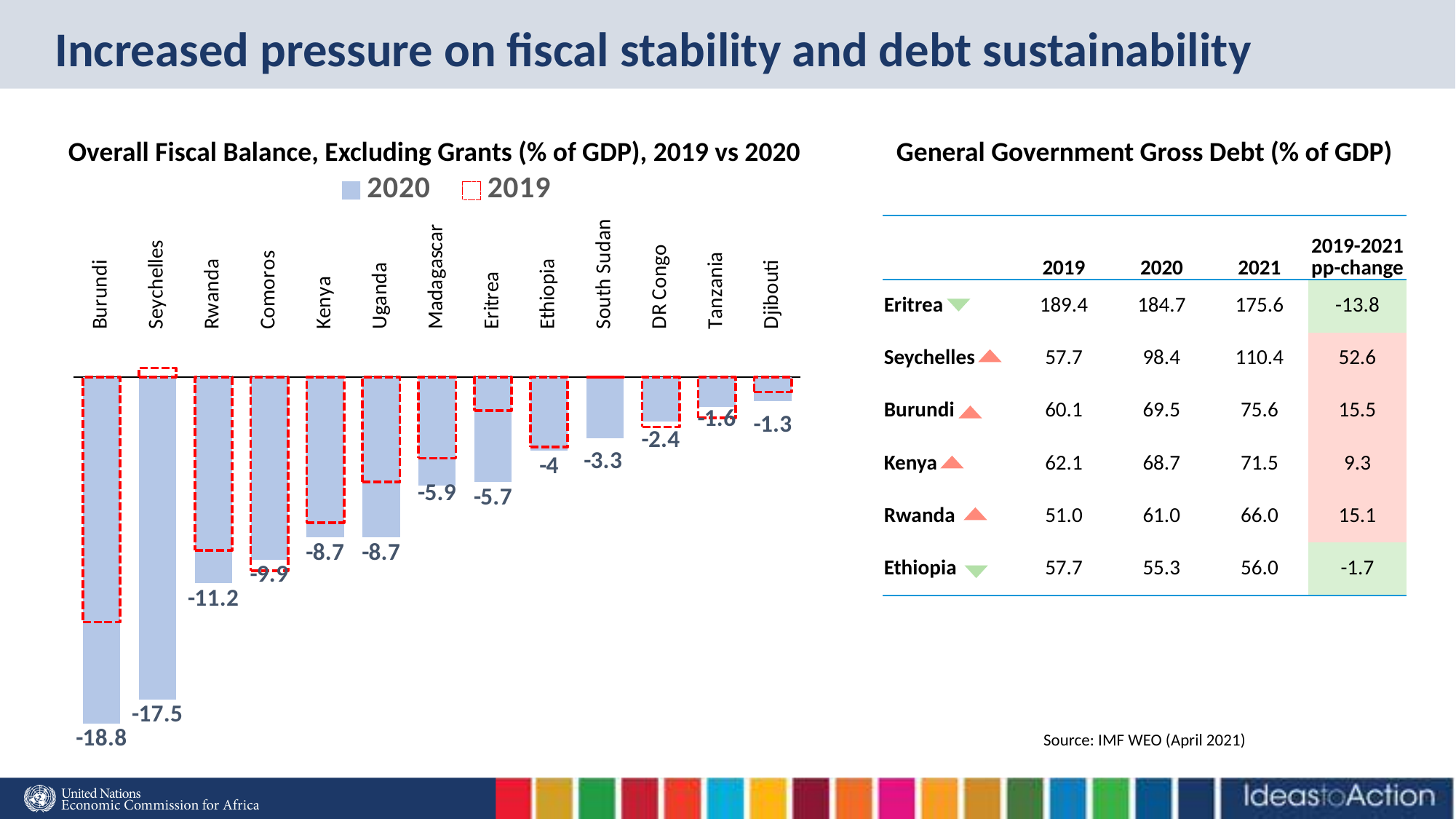
In the Overall Fiscal Balance chart, what is the 2020 value for Madagascar? -5.9 In the Overall Fiscal Balance chart, what is the 2020 value for Seychelles? -17.5 How many countries are shown in the Overall Fiscal Balance chart? 13 How many series does the legend of the Overall Fiscal Balance chart list? 2 In the Overall Fiscal Balance chart, which has a larger (less negative) 2020 value, Ethiopia or Eritrea? Ethiopia In the Overall Fiscal Balance chart, what is the 2020 value for Djibouti? -1.3 In the Overall Fiscal Balance chart, which country has the lowest (most negative) 2020 value? Burundi In the Overall Fiscal Balance chart, what is the 2020 value for Burundi? -18.8 In the Overall Fiscal Balance chart, do the 2020 values rise or fall from left to right? rise What type of chart is used for Overall Fiscal Balance, Excluding Grants (% of GDP), 2019 vs 2020? bar chart In the Overall Fiscal Balance chart, what is the difference between the 2020 values for Rwanda and Comoros? 1.3 In the Overall Fiscal Balance chart, which country has the highest (least negative) 2020 value? Djibouti